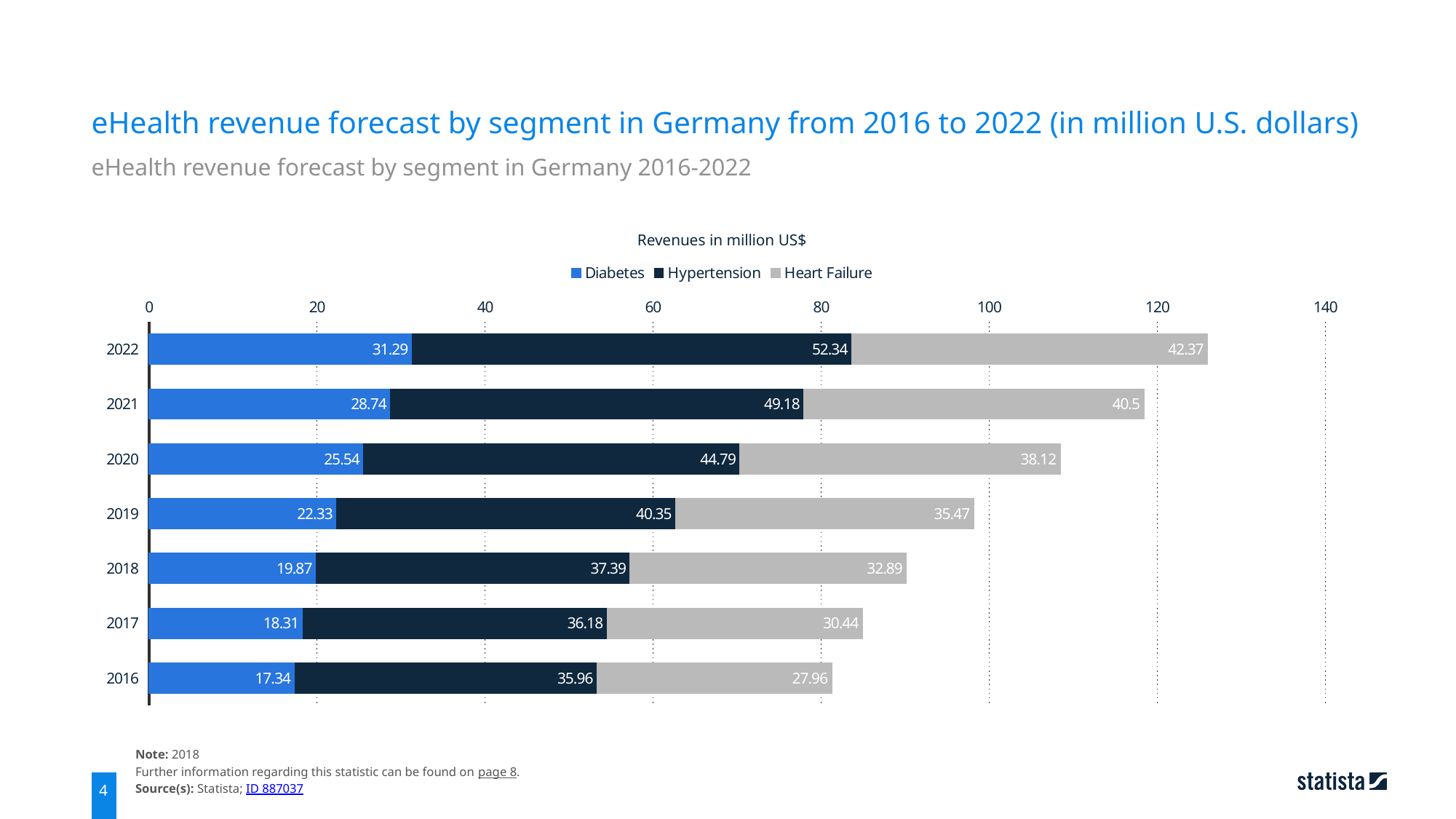
What is the difference between the Hypertension revenue in 2022 and in 2016? 16.38 What is the total revenue across all three segments for 2016? 81.26 How many years are shown in the chart? 7 What is the Heart Failure revenue for 2016? 27.96 What is the Hypertension revenue for 2019? 40.35 Which year has the lowest Diabetes revenue? 2016 How many series does the legend list? 3 Which year has the highest Hypertension revenue? 2022 What kind of chart is shown on the slide? Stacked bar chart What is the Diabetes revenue for 2022? 31.29 Which is larger, the Heart Failure revenue in 2020 or the Hypertension revenue in 2020? Hypertension revenue in 2020 What is the total revenue across all three segments for 2022? 126